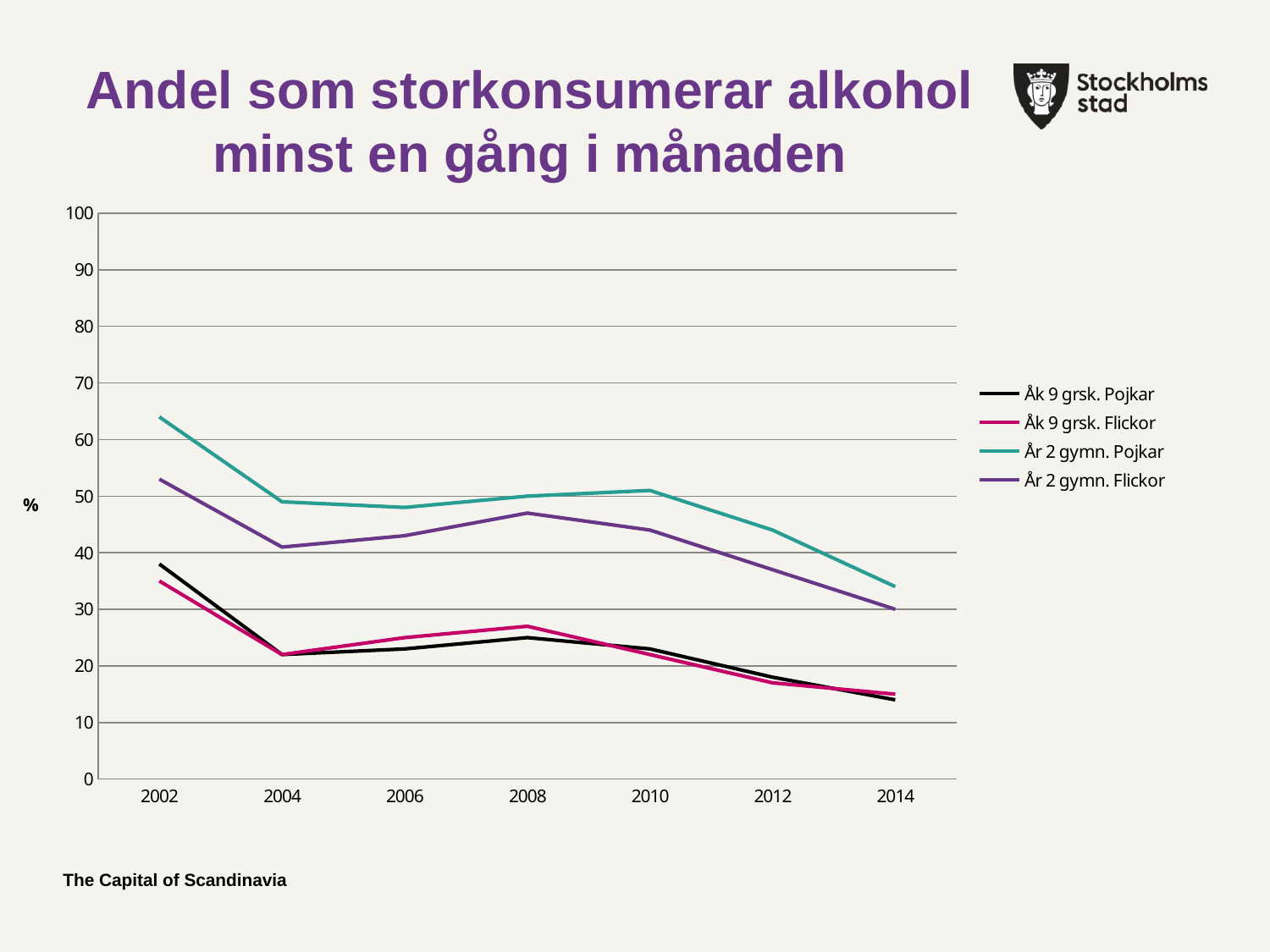
Is the value for Åk 9 grsk. Flickor in 2008 greater or less than 30? less Does the value for År 2 gymn. Flickor rise or fall from 2002 to 2014 overall? fall Is the value for Åk 9 grsk. Pojkar in 2014 greater or less than 20? less How many years are shown on the x axis? 7 In 2002, which is larger: the value for År 2 gymn. Pojkar or the value for År 2 gymn. Flickor? År 2 gymn. Pojkar Is the value for År 2 gymn. Pojkar in 2014 greater or less than 30? greater What is the label on the y axis of the chart? % Which series has the highest value in 2002? År 2 gymn. Pojkar In 2012, which is larger: the value for År 2 gymn. Pojkar or the value for Åk 9 grsk. Pojkar? År 2 gymn. Pojkar What kind of chart is shown on the slide? line chart How many series does the legend list? 4